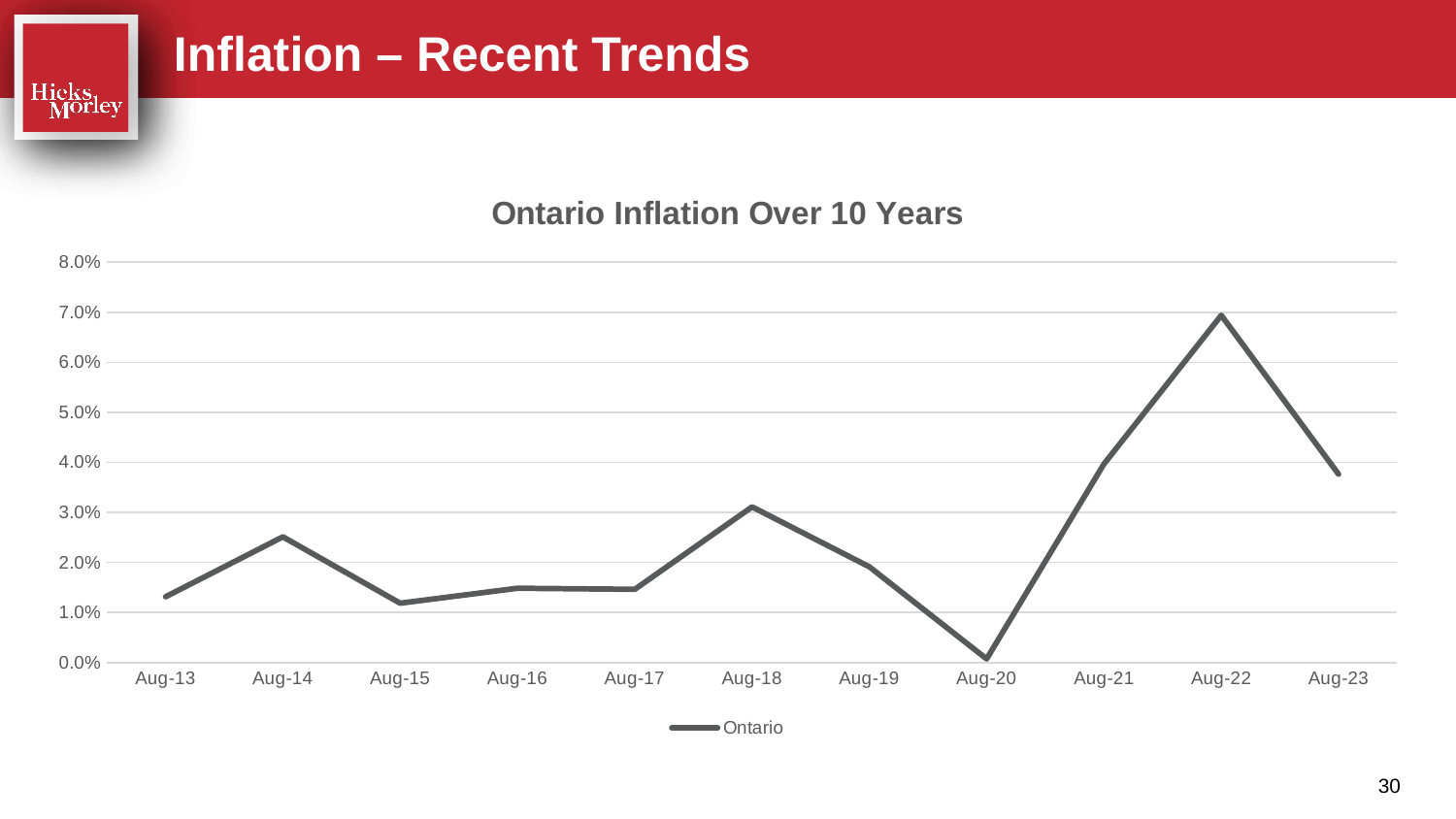
How many series does the legend list? 1 Is the value for Aug-20 greater or less than 1.0%? less How many data points are plotted along the x axis? 11 In which month is Ontario inflation lowest? Aug-20 Does Ontario inflation rise or fall from Aug-22 to Aug-23? Fall Is the value for Aug-23 greater or less than 5.0%? less Is the value for Aug-22 greater or less than 6.0%? greater In which month is Ontario inflation highest? Aug-22 What is the title of the chart? Ontario Inflation Over 10 Years What kind of chart is shown on the slide? Line chart Which is larger, the value for Aug-18 or the value for Aug-19? Aug-18